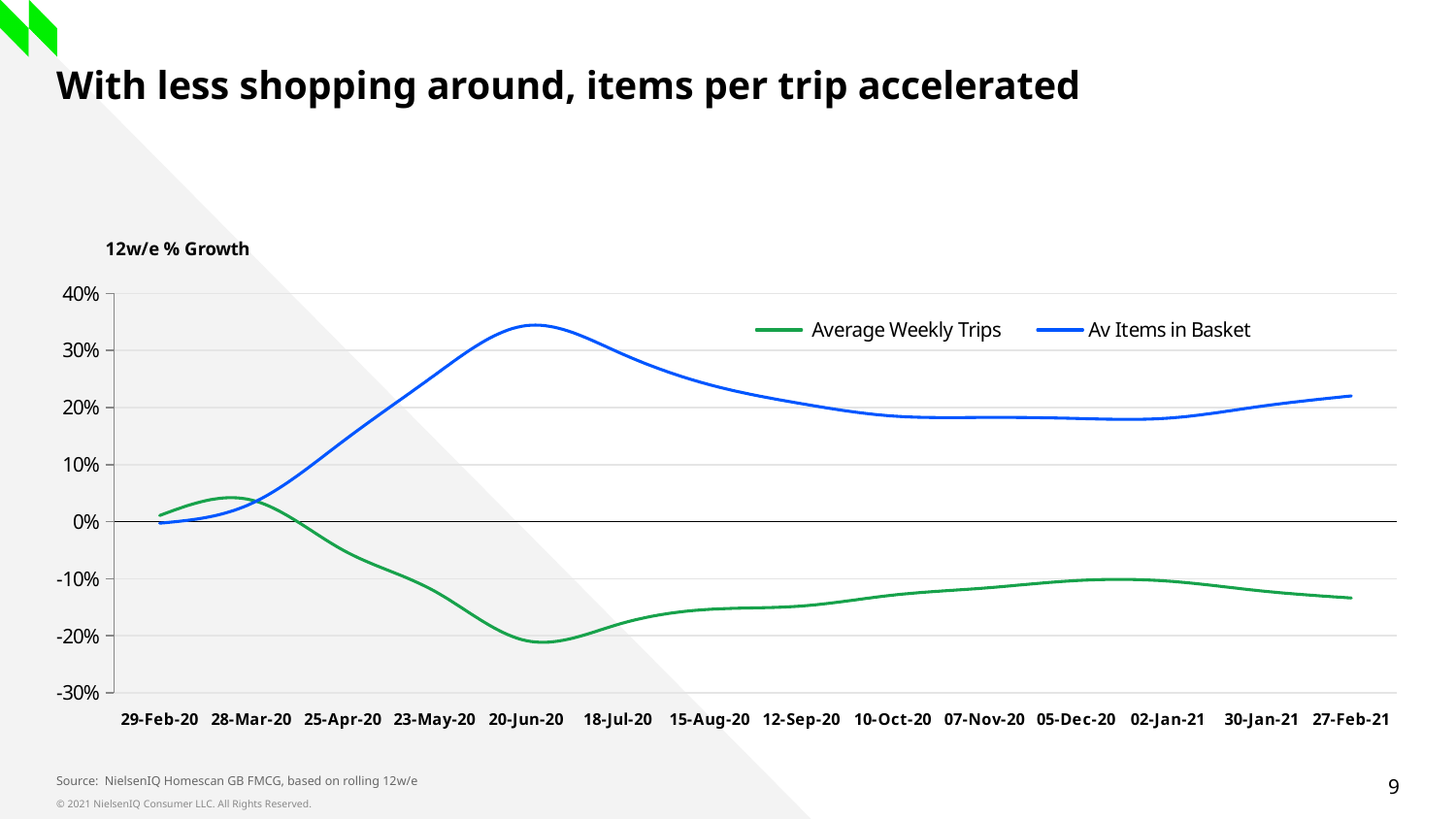
At which date does Av Items in Basket reach its highest value? 20-Jun-20 At which date does Average Weekly Trips reach its lowest value? 20-Jun-20 Does the Av Items in Basket line rise or fall between 29-Feb-20 and 20-Jun-20? rise Is the value for Av Items in Basket at 20-Jun-20 greater or less than 30%? greater What is the title shown above the chart? 12w/e % Growth At 20-Jun-20, which series has the higher value, Average Weekly Trips or Av Items in Basket? Av Items in Basket How many series does the legend list? 2 Is the value for Average Weekly Trips at 20-Jun-20 greater or less than -10%? less Is the value for Av Items in Basket at 29-Feb-20 greater or less than 10%? less What kind of chart is shown on the slide? Line chart How many date labels are shown along the x axis? 14